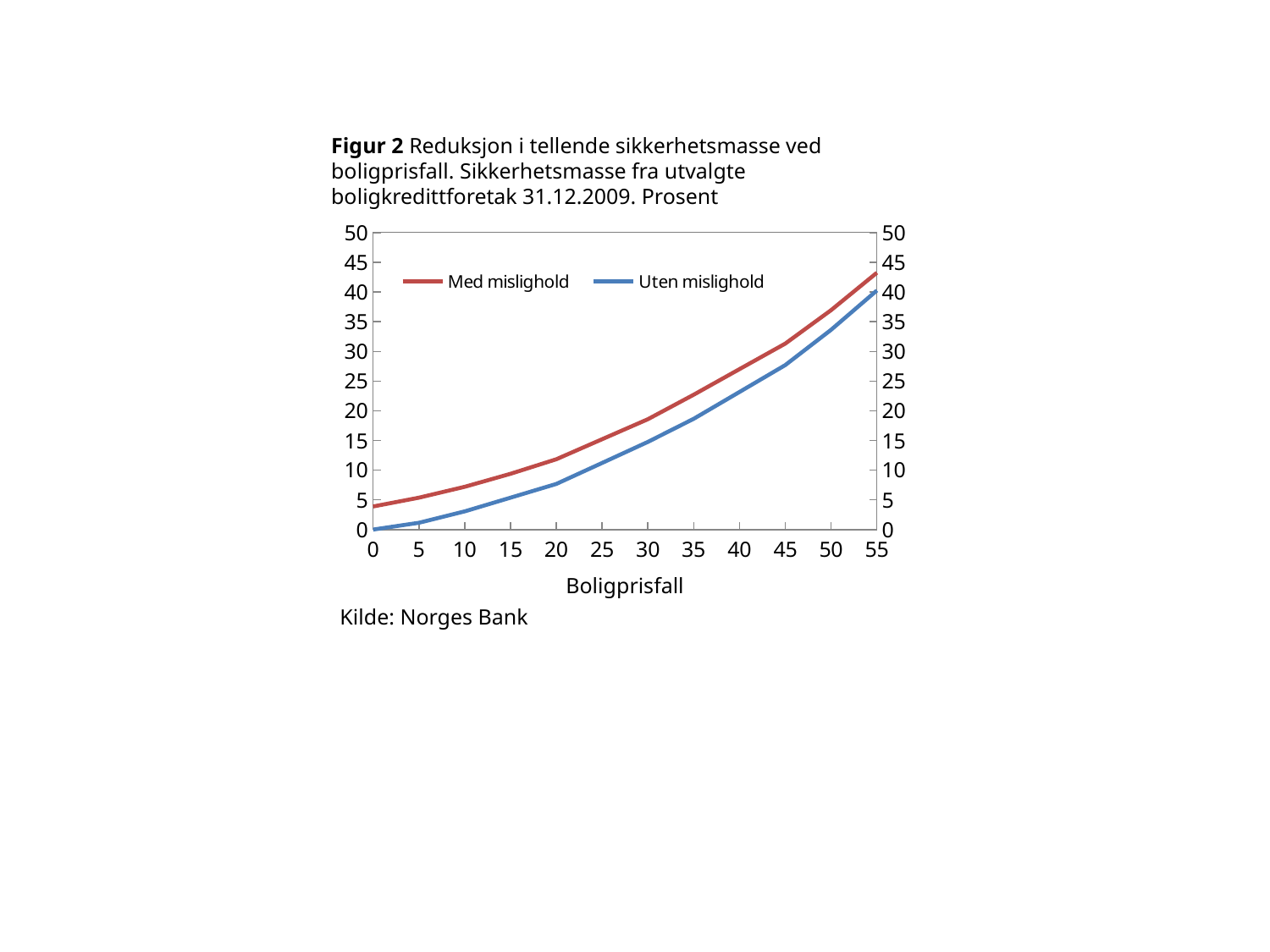
What is the label of the x axis? Boligprisfall Is the value of the Uten mislighold series at a Boligprisfall of 55 greater or less than 45? less What colour is the line for the Med mislighold series? red Is the value of the Uten mislighold series at a Boligprisfall of 30 greater or less than 20? less How many series does the legend list? 2 Is the value of the Med mislighold series at a Boligprisfall of 55 greater or less than 40? greater Do the values of the Uten mislighold series rise or fall as Boligprisfall increases along the x axis? rise What kind of chart is shown on the slide? line chart At a Boligprisfall of 30, which series has the larger value, Med mislighold or Uten mislighold? Med mislighold Do the values of the Med mislighold series rise or fall as Boligprisfall increases from 0 to 55? rise